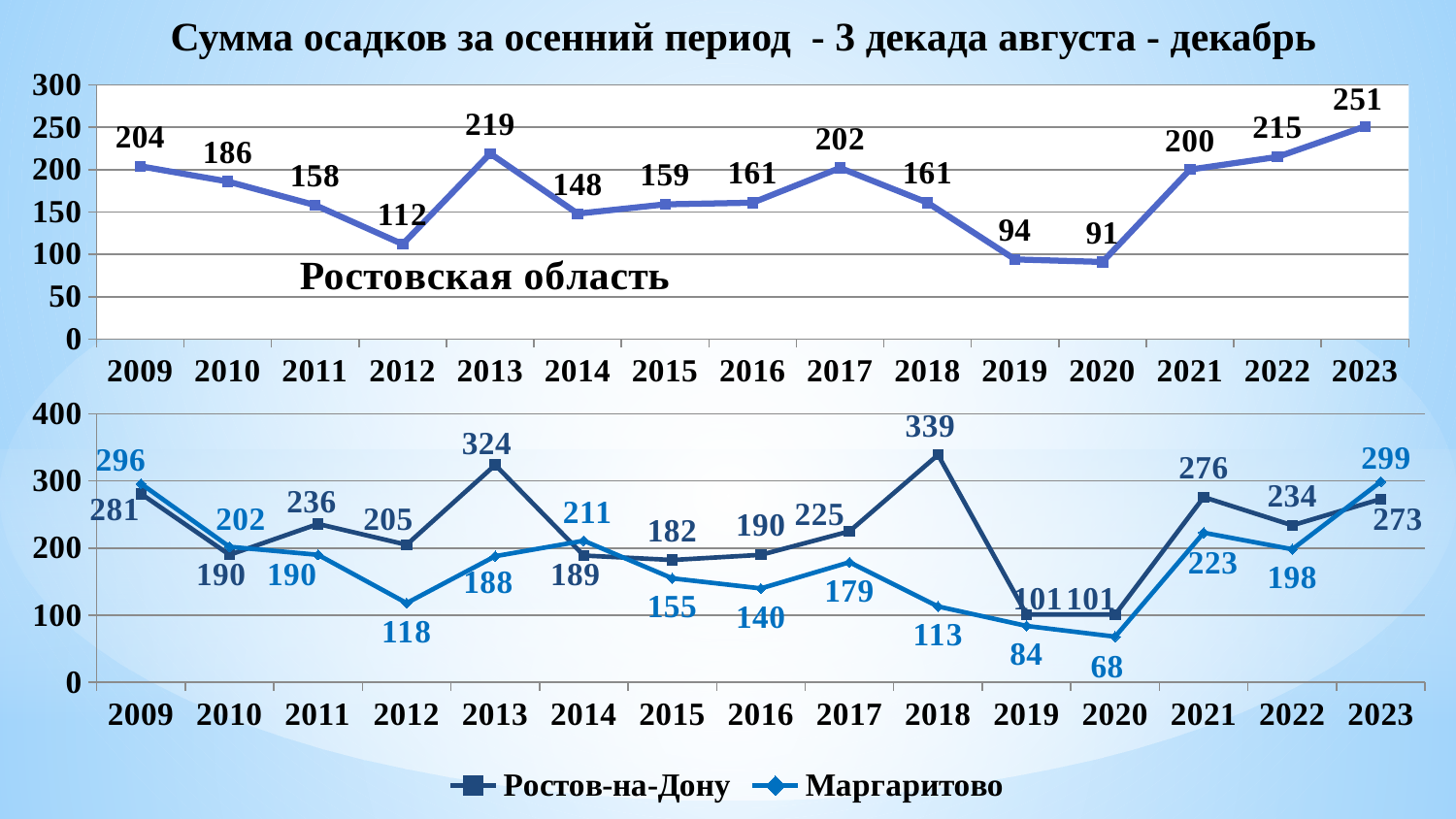
In the bottom chart, which year has the highest value for Ростов-на-Дону? 2018 In the bottom chart, what is the value for Ростов-на-Дону in 2018? 339 In the top chart (Ростовская область), what is the value for 2013? 219 In the bottom chart, what is the difference between Ростов-на-Дону and Маргаритово in 2018? 226 In the top chart (Ростовская область), what is the difference between the values for 2023 and 2020? 160 In the bottom chart, which is larger in 2014: Ростов-на-Дону or Маргаритово? Маргаритово In the bottom chart, what is the value for Маргаритово in 2020? 68 How many series does the legend of the bottom chart list? 2 In the top chart (Ростовская область), which year has the lowest value? 2020 In the top chart (Ростовская область), how many years are plotted? 15 What type of chart is the top chart? Line chart In the top chart (Ростовская область), which year has the highest value? 2023